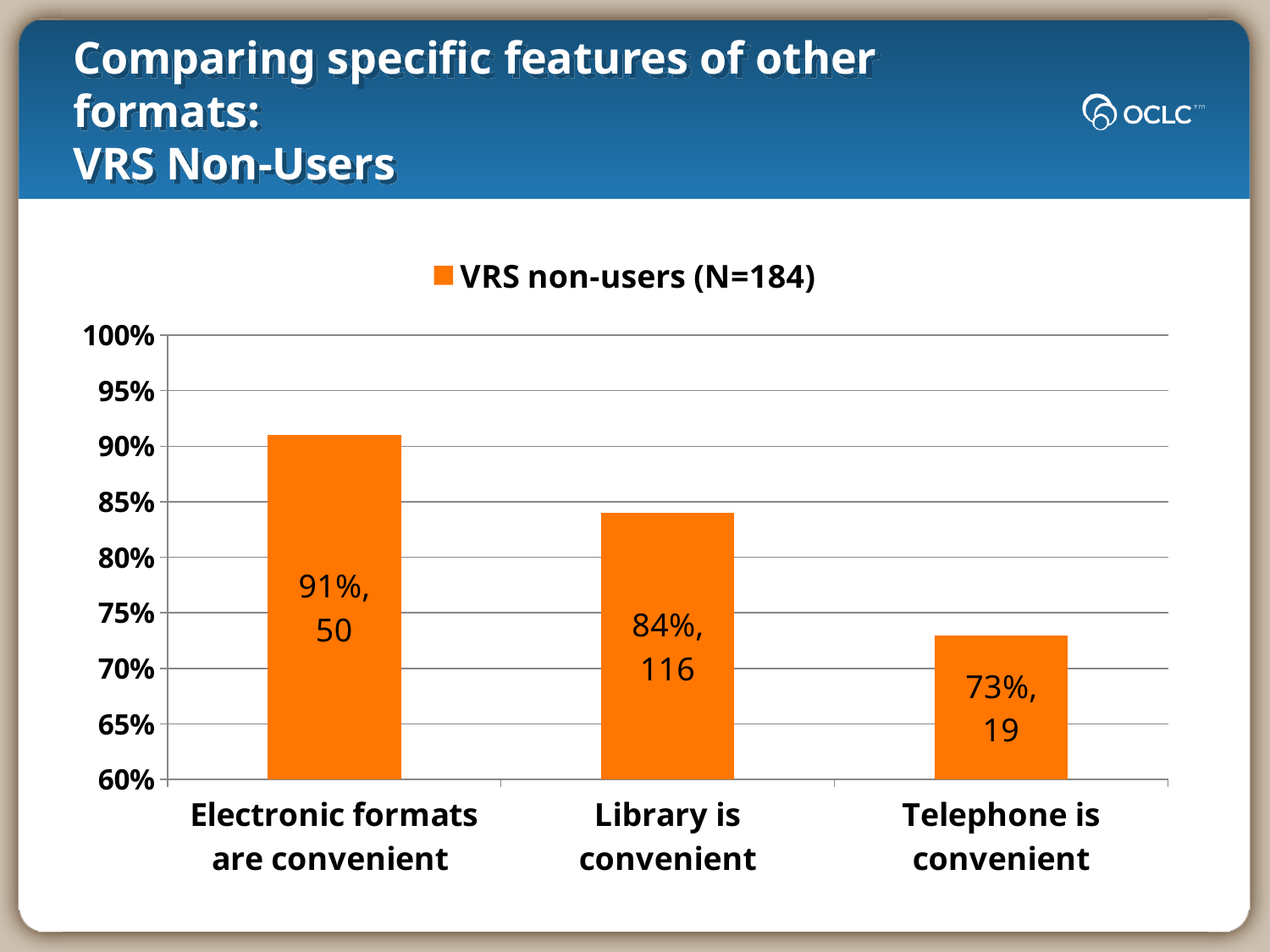
What count is printed on the bar for 'Library is convenient'? 116 What kind of chart is shown on the slide? Bar chart What percentage is shown for 'Library is convenient'? 84% Which is larger: the percentage for 'Library is convenient' or for 'Telephone is convenient'? Library is convenient How many series does the legend list? 1 Which category has the lowest percentage? Telephone is convenient Which category has the highest percentage? Electronic formats are convenient What percentage is shown for 'Electronic formats are convenient'? 91% What is the legend entry for the series shown? VRS non-users (N=184) What is the difference in percentage points between 'Electronic formats are convenient' and 'Telephone is convenient'? 18 What percentage is shown for 'Telephone is convenient'? 73% How many categories are shown on the x axis? 3